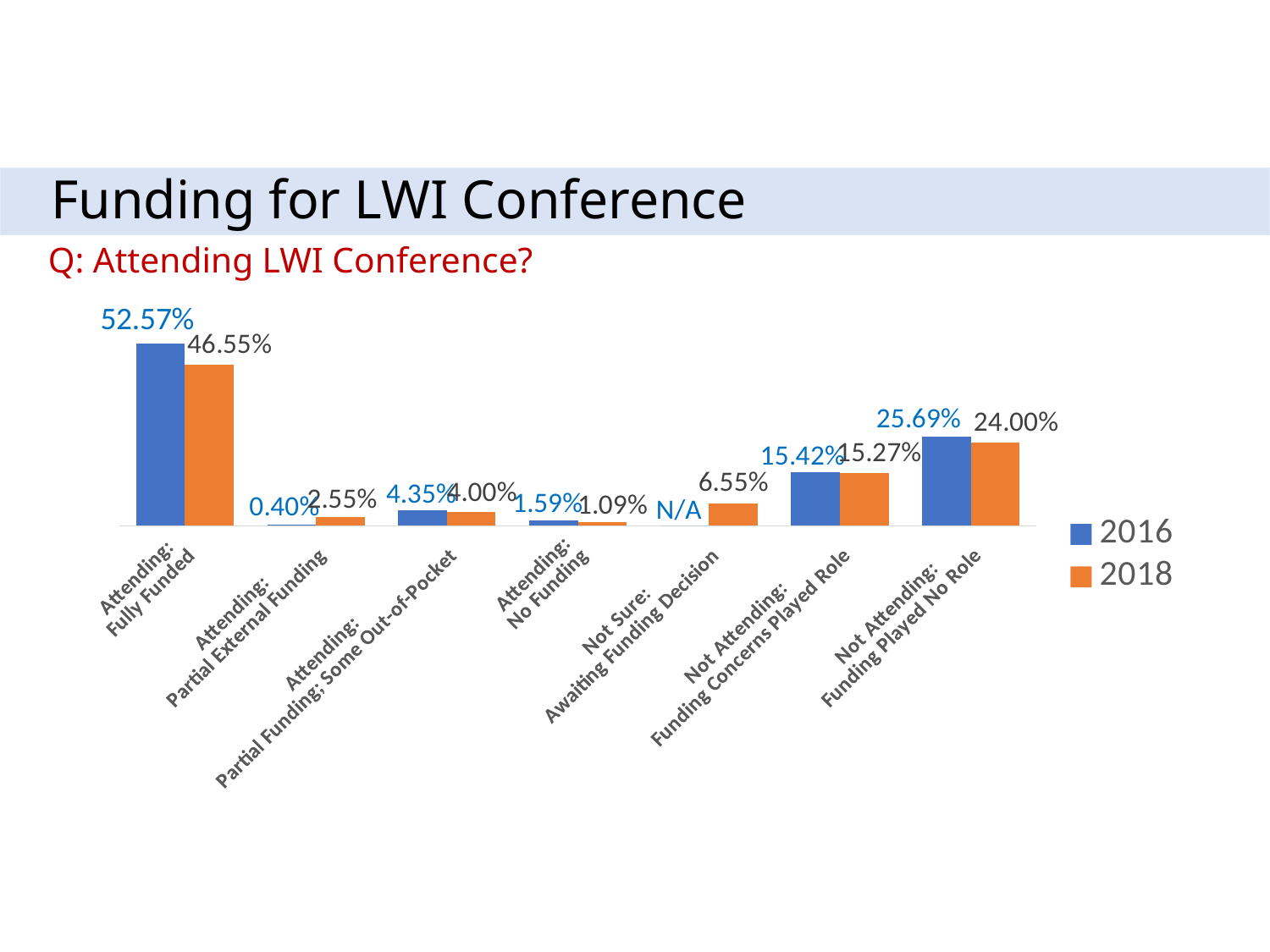
How many categories are shown on the x axis? 7 What kind of chart is shown on the slide? Bar chart Which category has the highest 2016 value? Attending: Fully Funded What is the 2018 value for "Not Attending: Funding Played No Role"? 24.00% What is the 2016 value for "Attending: Fully Funded"? 52.57% How many series does the legend list? 2 What is the 2016 value for "Not Attending: Funding Concerns Played Role"? 15.42% What is the 2018 value for "Attending: Fully Funded"? 46.55% What is the difference between the 2016 and 2018 values for "Attending: Fully Funded"? 6.02% What is the 2016 value for "Not Attending: Funding Played No Role"? 25.69% What is the 2018 value for "Not Sure: Awaiting Funding Decision"? 6.55% For "Attending: Fully Funded", which year has the larger value, 2016 or 2018? 2016